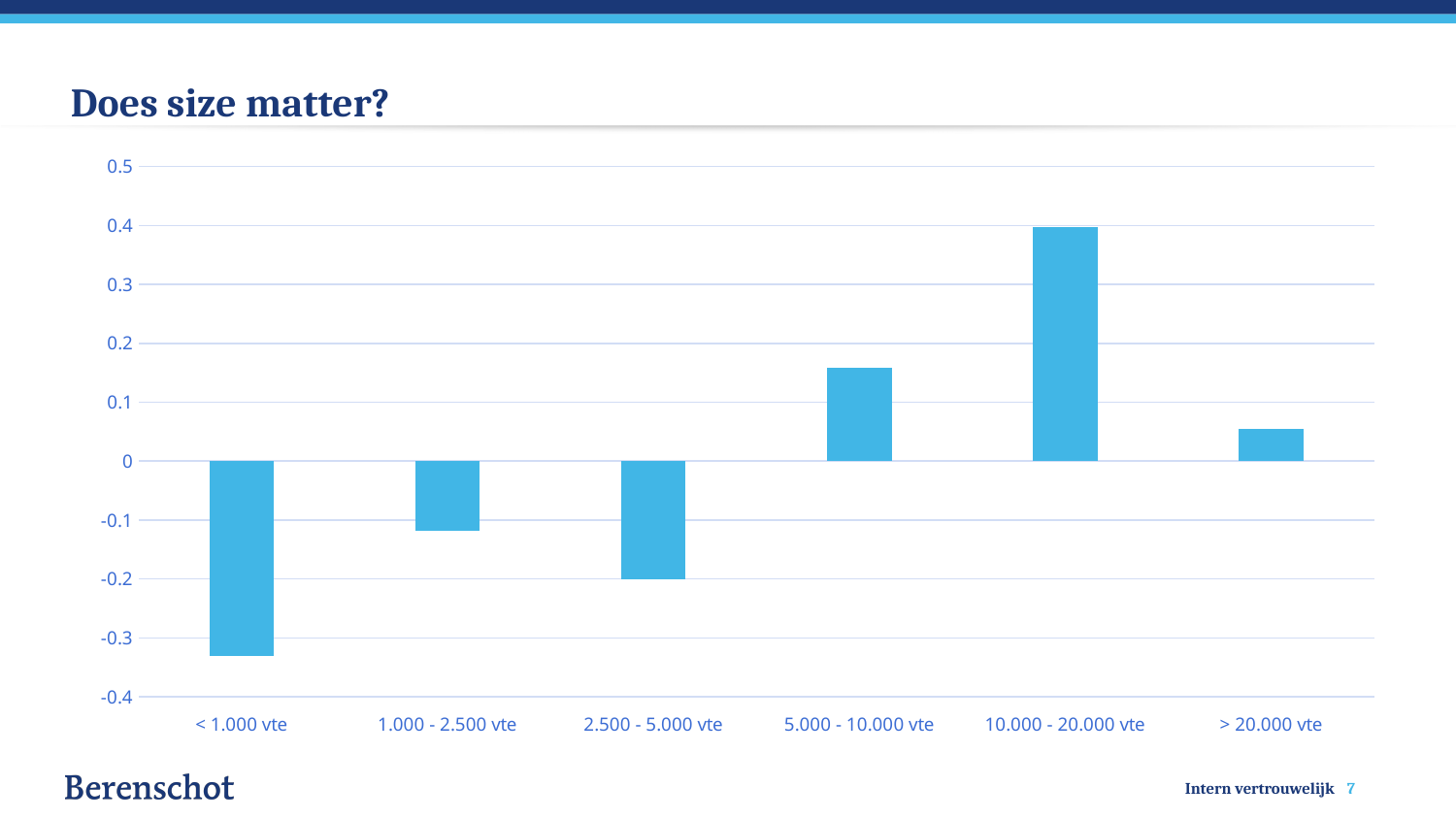
How many size categories are shown on the x axis? 6 Which has the larger value, 5.000 - 10.000 vte or > 20.000 vte? 5.000 - 10.000 vte Which has the lower value, 1.000 - 2.500 vte or 2.500 - 5.000 vte? 2.500 - 5.000 vte What is the title of the slide? Does size matter? What kind of chart is shown on the slide? bar chart Is the value for > 20.000 vte greater or less than 0.1? less Is the value for 5.000 - 10.000 vte greater or less than 0.1? greater Is the value for 1.000 - 2.500 vte greater or less than 0? less Which category has the highest value? 10.000 - 20.000 vte Which category has the lowest value? < 1.000 vte